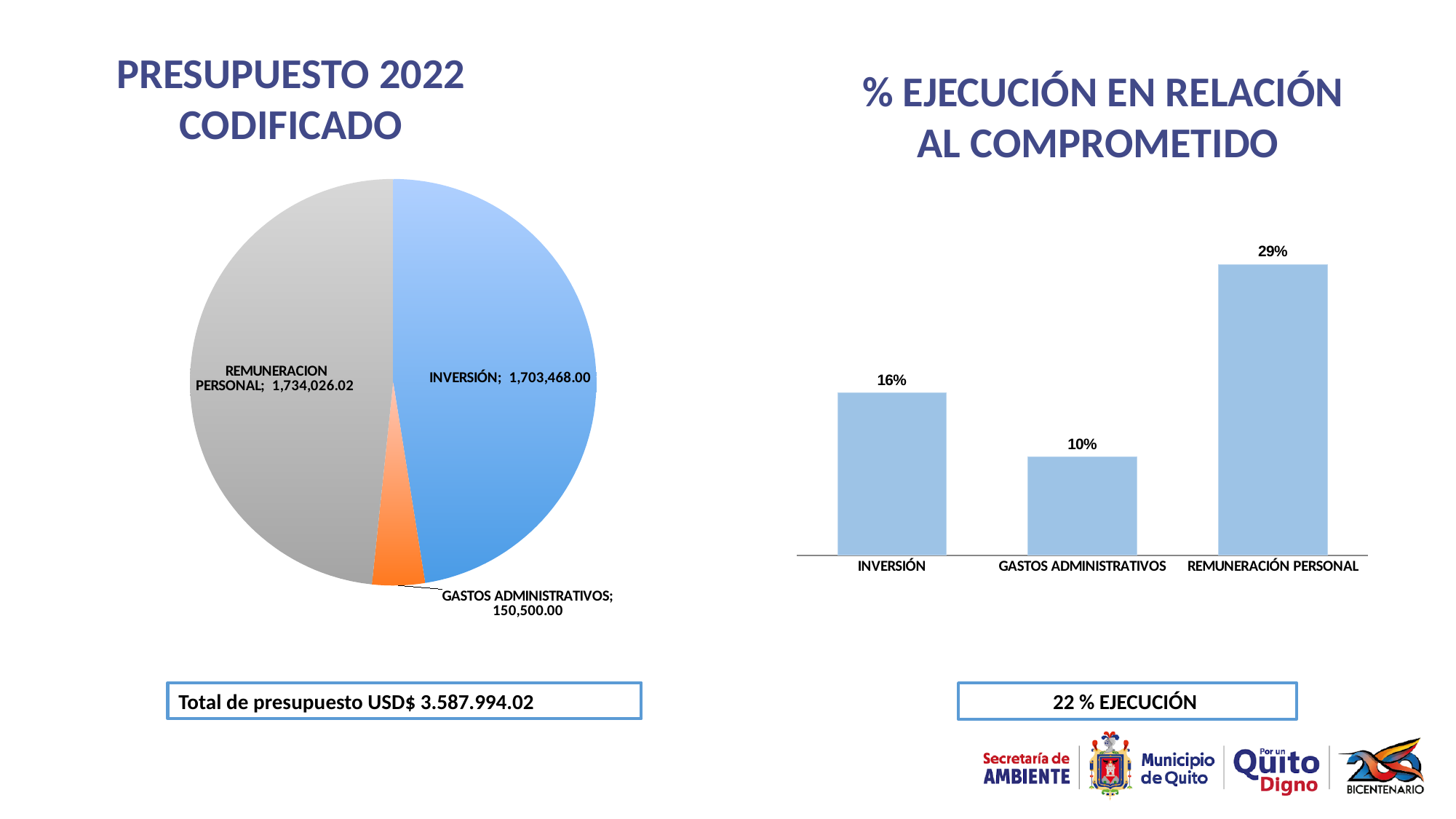
In the PRESUPUESTO 2022 CODIFICADO pie chart, what is the value for GASTOS ADMINISTRATIVOS? 150,500.00 In the PRESUPUESTO 2022 CODIFICADO pie chart, what is the value for INVERSIÓN? 1,703,468.00 In the % EJECUCIÓN EN RELACIÓN AL COMPROMETIDO chart, which is larger, INVERSIÓN or GASTOS ADMINISTRATIVOS? INVERSIÓN In the % EJECUCIÓN EN RELACIÓN AL COMPROMETIDO chart, which category has the highest value? REMUNERACIÓN PERSONAL In the % EJECUCIÓN EN RELACIÓN AL COMPROMETIDO chart, what is the difference between REMUNERACIÓN PERSONAL and INVERSIÓN? 13 percentage points In the PRESUPUESTO 2022 CODIFICADO pie chart, how many slices are there? 3 What kind of chart is the PRESUPUESTO 2022 CODIFICADO chart? Pie chart In the PRESUPUESTO 2022 CODIFICADO pie chart, which category has the largest value? REMUNERACION PERSONAL In the PRESUPUESTO 2022 CODIFICADO pie chart, which category has the smallest slice? GASTOS ADMINISTRATIVOS In the % EJECUCIÓN EN RELACIÓN AL COMPROMETIDO chart, what is the value for GASTOS ADMINISTRATIVOS? 10% What kind of chart is the % EJECUCIÓN EN RELACIÓN AL COMPROMETIDO chart? Bar chart In the % EJECUCIÓN EN RELACIÓN AL COMPROMETIDO chart, what is the value for REMUNERACIÓN PERSONAL? 29%